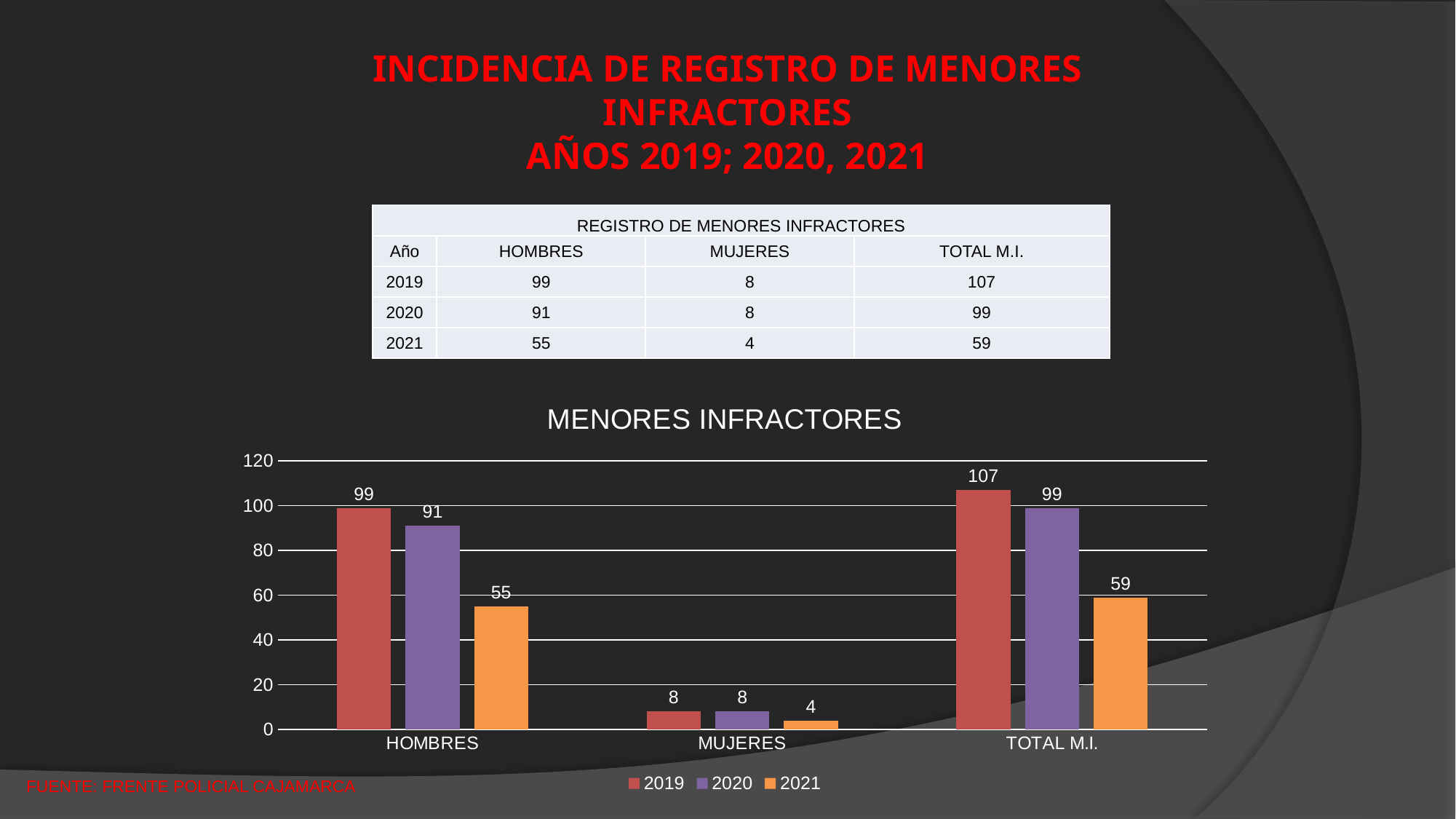
What is the value for TOTAL M.I. in the 2020 series? 99 How many series does the legend list? 3 Which category has the lowest value in the 2020 series? MUJERES Which is larger for TOTAL M.I.: the 2019 value or the 2021 value? 2019 What is the value for HOMBRES in the 2019 series? 99 Which category has the highest value in the 2019 series? TOTAL M.I. Is the value for HOMBRES in 2021 greater or less than 60? less How many categories are shown on the x axis? 3 What is the difference between the 2019 and 2021 values for HOMBRES? 44 What is the title of the chart? MENORES INFRACTORES What kind of chart is shown? bar chart What is the value for MUJERES in the 2021 series? 4